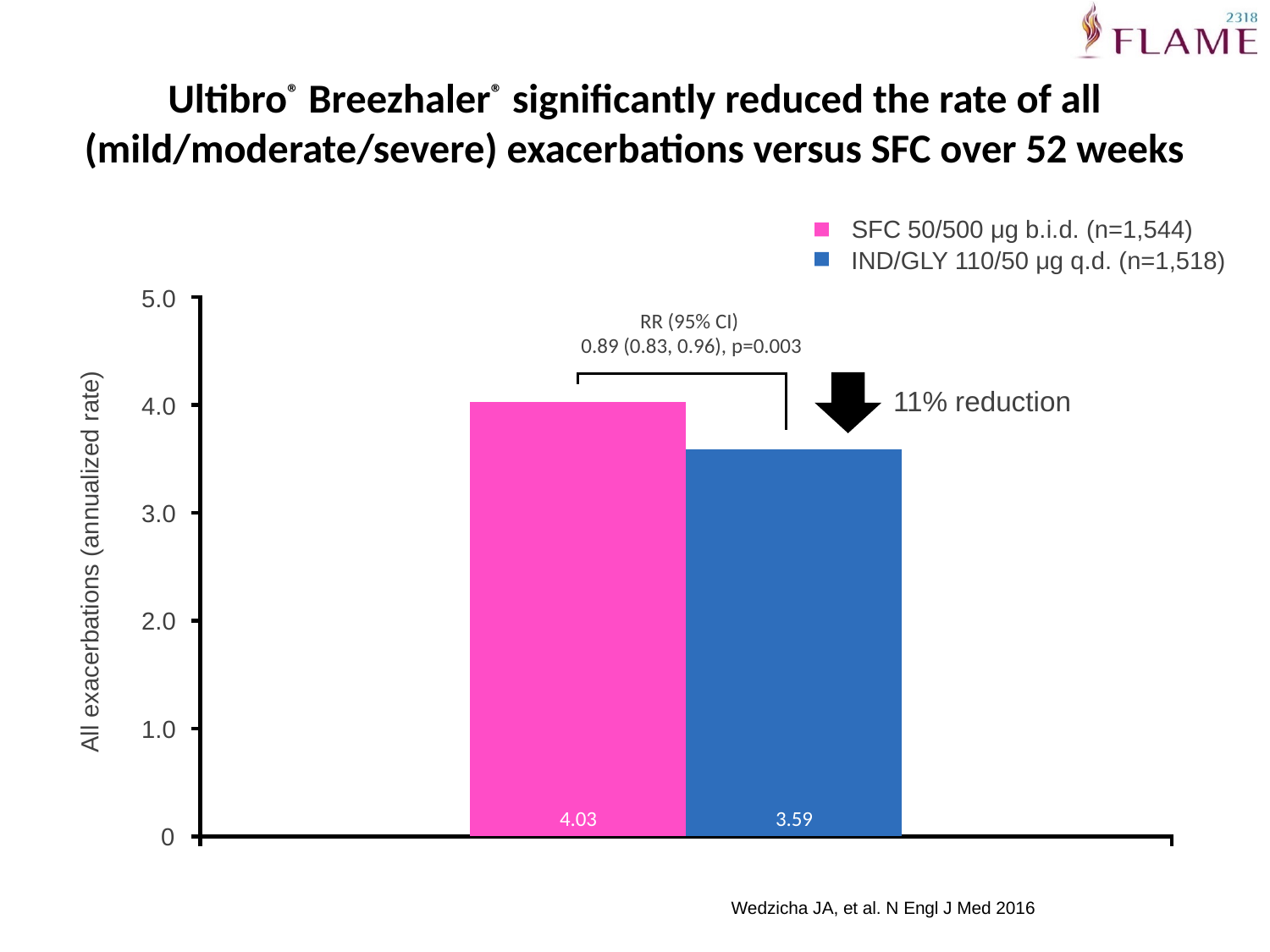
What is the label of the y axis? All exacerbations (annualized rate) What is the annualized rate of all exacerbations for IND/GLY 110/50 µg q.d.? 3.59 Is the annualized exacerbation rate for IND/GLY greater or less than 4.0? less How many bars are plotted in the chart? 2 Which treatment group has the higher annualized rate of all exacerbations? SFC 50/500 µg b.i.d. How many series does the legend list? 2 What is the difference between the SFC and IND/GLY annualized exacerbation rates? 0.44 What is the annualized rate of all exacerbations for SFC 50/500 µg b.i.d.? 4.03 Which treatment group has the lower annualized rate of all exacerbations? IND/GLY 110/50 µg q.d. What colour is the bar for IND/GLY 110/50 µg q.d.? Blue What kind of chart is shown on the slide? Bar chart Is the annualized exacerbation rate for SFC greater or less than 4.0? greater